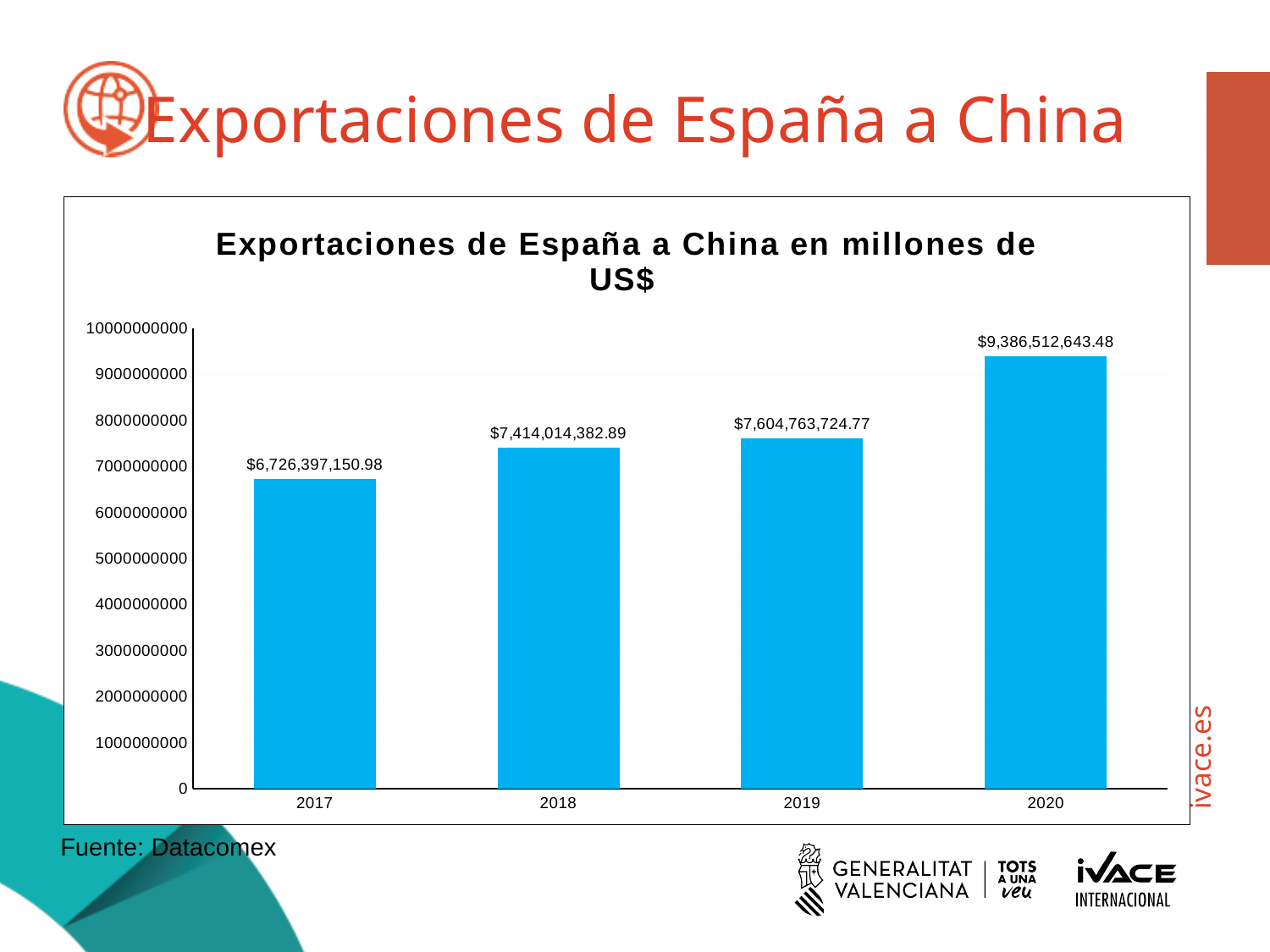
What is the value for 2019? $7,604,763,724.77 What is the difference between the values for 2020 and 2019? $1,781,748,918.71 Which year has the lowest value? 2017 Which is larger, the value for 2018 or the value for 2019? 2019 How many years are shown on the x axis? 4 Is the value for 2017 greater or less than 7000000000? less What is the value for 2017? $6,726,397,150.98 What kind of chart is shown? bar chart What is the value for 2020? $9,386,512,643.48 What is the value for 2018? $7,414,014,382.89 What is the difference between the values for 2018 and 2017? $687,617,231.91 Which year has the highest value? 2020